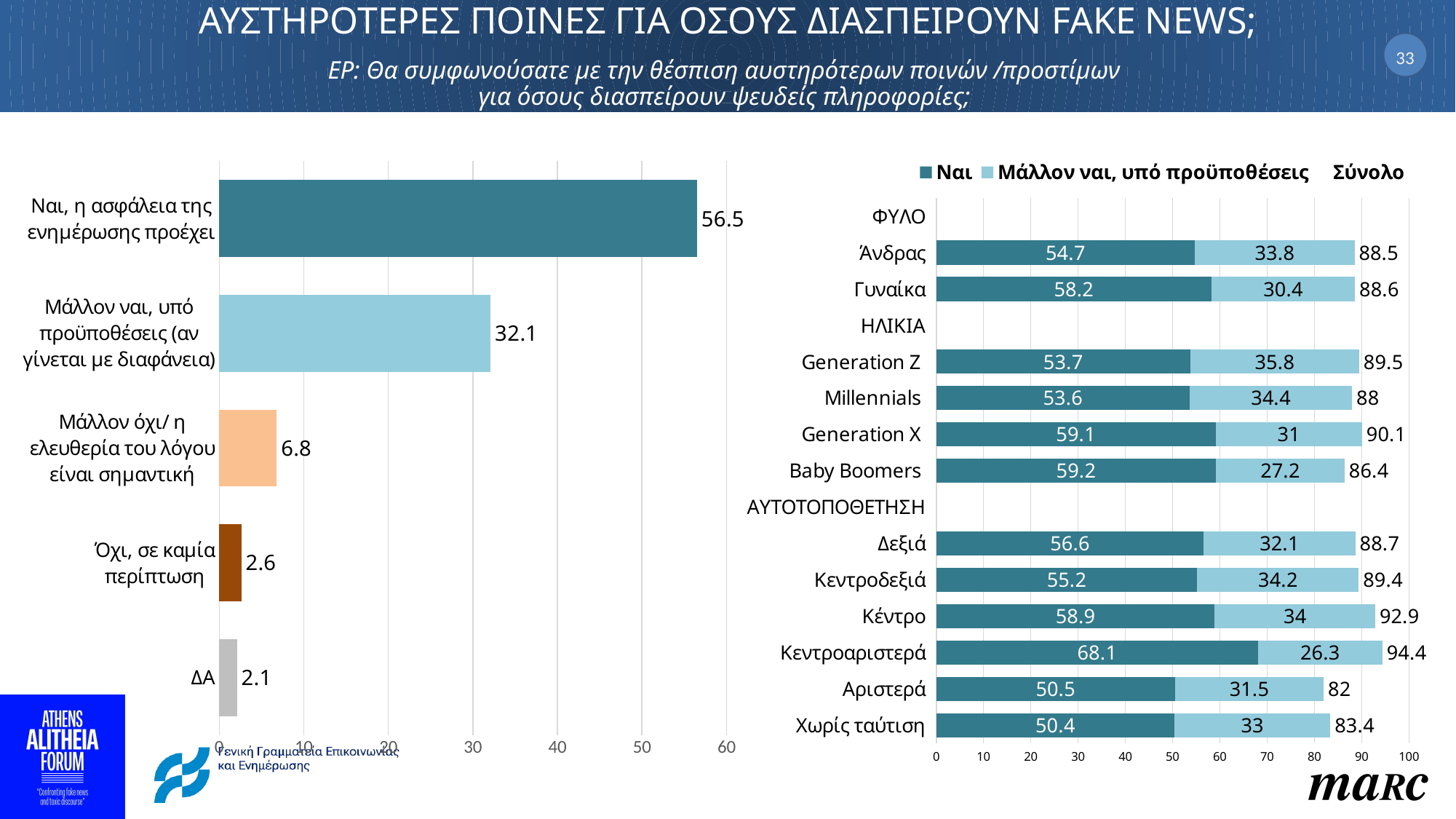
In the left bar chart, what is the difference between the value for "Ναι, η ασφάλεια της ενημέρωσης προέχει" and the value for "Μάλλον ναι, υπό προϋποθέσεις"? 24.4 In the right stacked bar chart, which group has the lowest Σύνολο value? Αριστερά How many categories are shown in the left bar chart? 5 In the left bar chart, what is the value for "Ναι, η ασφάλεια της ενημέρωσης προέχει"? 56.5 In the right stacked bar chart, which group has the highest Σύνολο value? Κεντροαριστερά In the right stacked bar chart, which has the larger "Ναι" value, Άνδρας or Γυναίκα? Γυναίκα How many entries does the legend of the right stacked bar chart list? 3 In the right stacked bar chart, what is the "Μάλλον ναι, υπό προϋποθέσεις" value for Generation Z? 35.8 What kind of chart is the chart on the left of the slide? Bar chart In the right stacked bar chart, what is the Σύνολο value for Κέντρο? 92.9 In the right stacked bar chart, what is the "Ναι" value for Κεντροαριστερά? 68.1 In the left bar chart, which category has the lowest value? ΔΑ